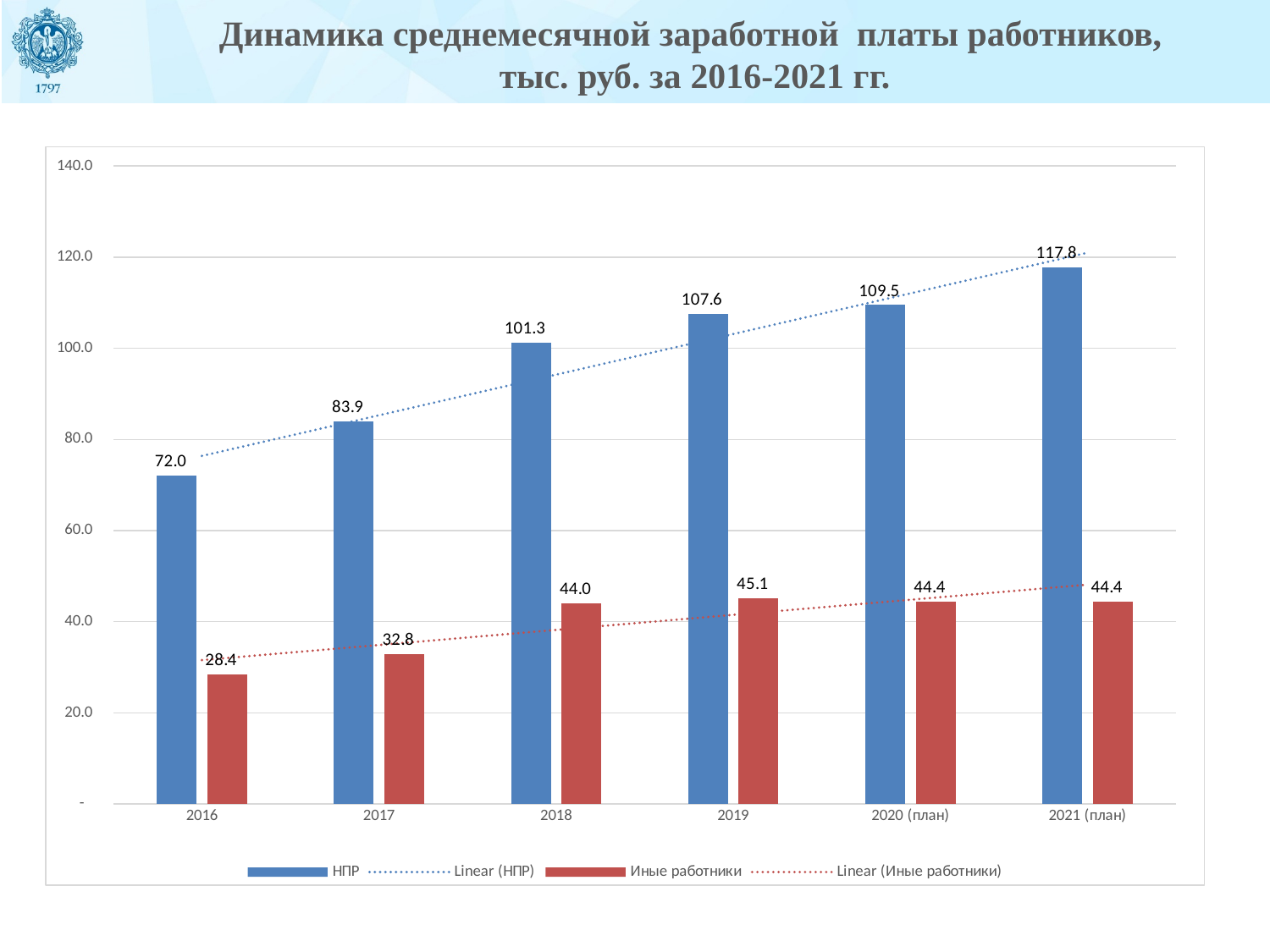
What is the difference between the НПР value in 2019 and the НПР value in 2016? 35.6 What is the value for Иные работники in 2017? 32.8 Is the value for НПР in 2017 greater or less than 80.0? greater What is the value for НПР in 2018? 101.3 What is the value for НПР in 2021 (план)? 117.8 How many entries does the legend list? 4 How many years are shown on the x axis? 6 In which year is the НПР value highest? 2021 (план) Do the НПР values rise or fall from 2016 to 2021 (план)? rise Which is larger: the Иные работники value in 2019 or in 2018? 2019 In which year is the Иные работники value lowest? 2016 What kind of chart is shown on the slide? bar chart